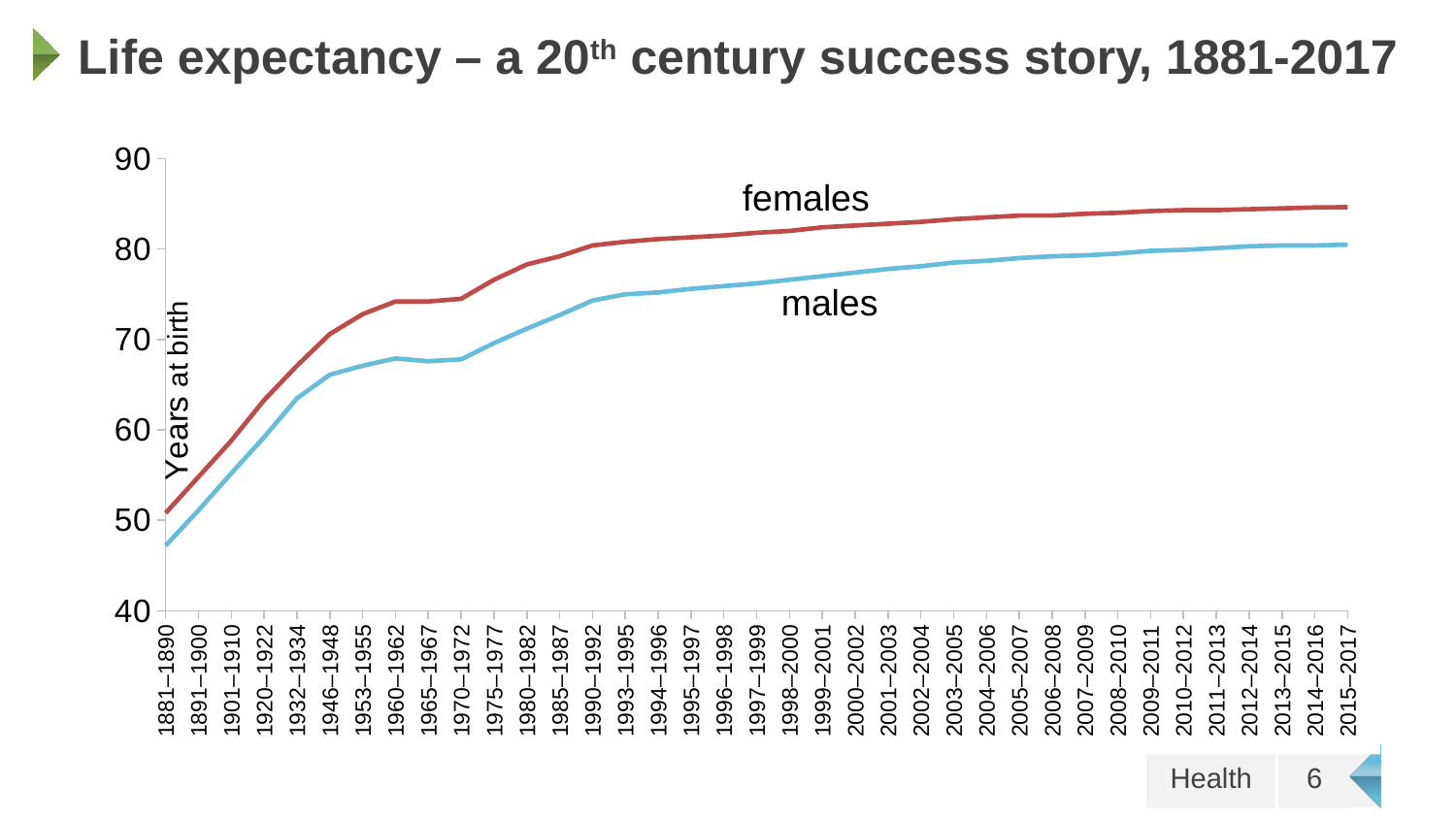
Is the value for males in 1881–1890 greater or less than 50? less Is the value for males in 1990–1992 greater or less than 80? less In which period is the value for females highest? 2015–2017 Do the values for females rise or fall along the x axis from 1881–1890 to 2015–2017? rise Which series has the larger value in 2015–2017, females or males? females Is the value for females in 2015–2017 greater or less than 80? greater How many periods are shown along the x axis of the chart? 37 What is the label on the y axis of the chart? Years at birth What kind of chart is shown on the slide? line chart In which period is the value for males lowest? 1881–1890 How many series are plotted on the chart? 2